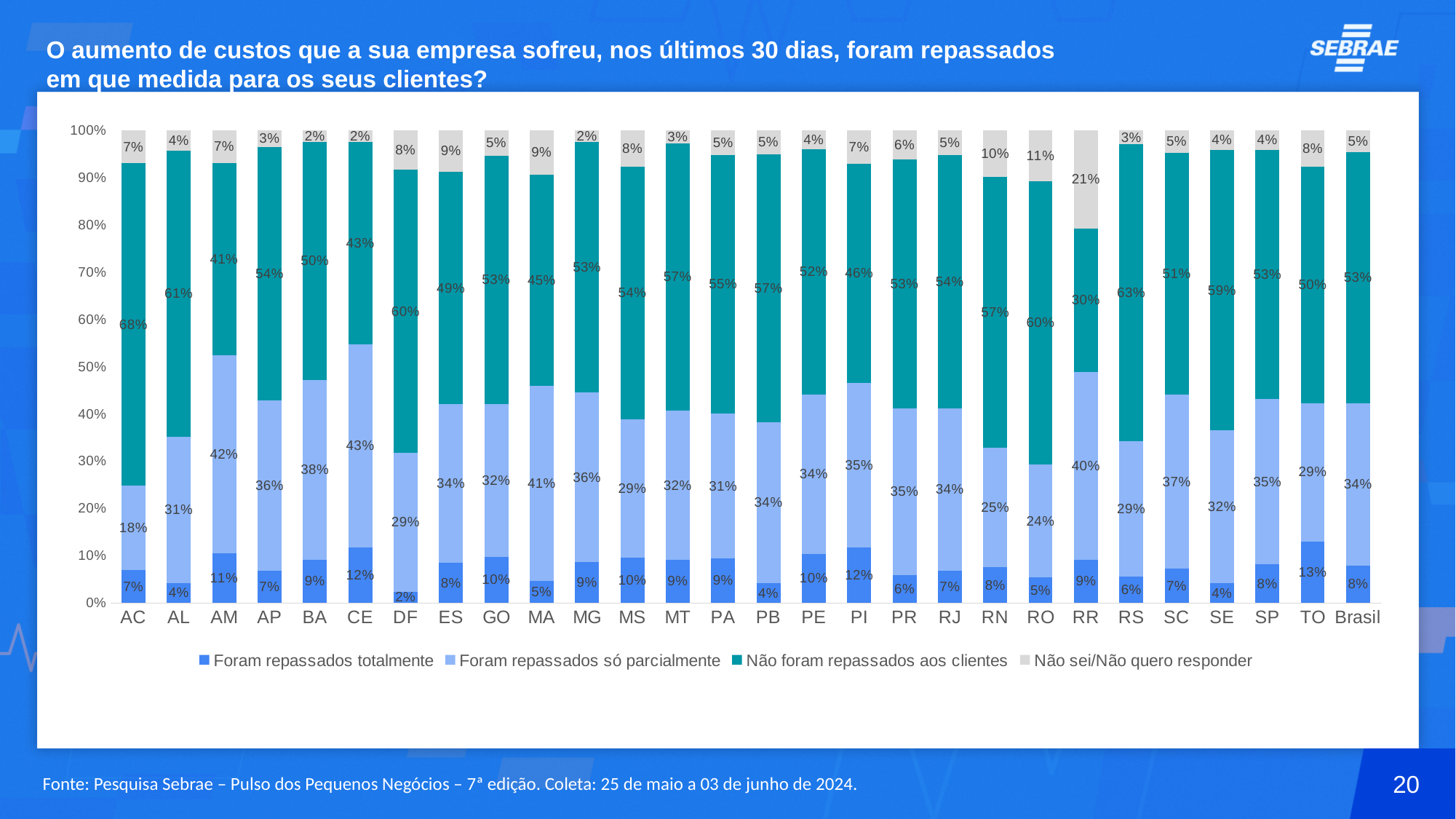
What percentage of respondents in Brasil said costs were 'Não foram repassados aos clientes'? 53% What is the value for 'Foram repassados totalmente' in TO? 13% What is the value for 'Não sei/Não quero responder' in RR? 21% How many categories are shown on the x axis? 28 Which state has the lowest value for 'Não foram repassados aos clientes'? RR Which is larger: the 'Foram repassados só parcialmente' value for AM or for RO? AM Which legend entry is shown in grey? Não sei/Não quero responder How many series does the legend list? 4 What is the difference between the 'Foram repassados só parcialmente' values for CE and AC? 25 percentage points What kind of chart is shown on the slide? Stacked bar chart Which state has the lowest value for 'Foram repassados totalmente'? DF Which state has the highest value for 'Não foram repassados aos clientes'? AC